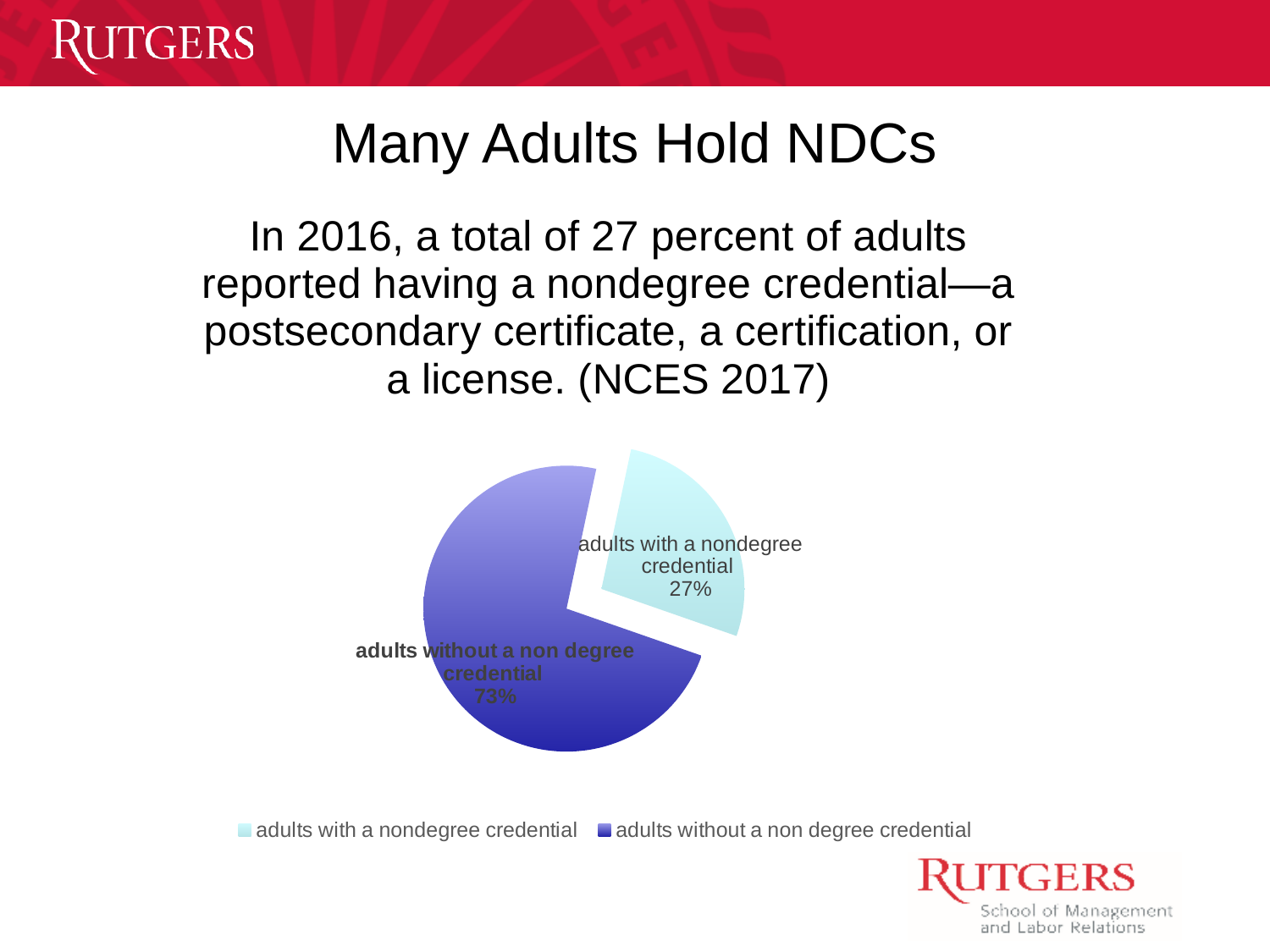
Which slice of the pie is shown in light blue? adults with a nondegree credential Which is larger: the share of adults with a nondegree credential or the share of adults without a non degree credential? adults without a non degree credential Which slice of the pie is the smallest? adults with a nondegree credential What is the title of the slide containing the pie chart? Many Adults Hold NDCs What is the total of the two slice percentages shown on the pie chart? 100% How many slices does the pie chart have? 2 Which slice of the pie is the largest? adults without a non degree credential What share of the pie is labelled 'adults without a non degree credential'? 73% What is the difference in percentage points between the 'adults without a non degree credential' slice and the 'adults with a nondegree credential' slice? 46 percentage points How many entries does the legend list? 2 What share of the pie is labelled 'adults with a nondegree credential'? 27% What kind of chart is shown on the slide? pie chart